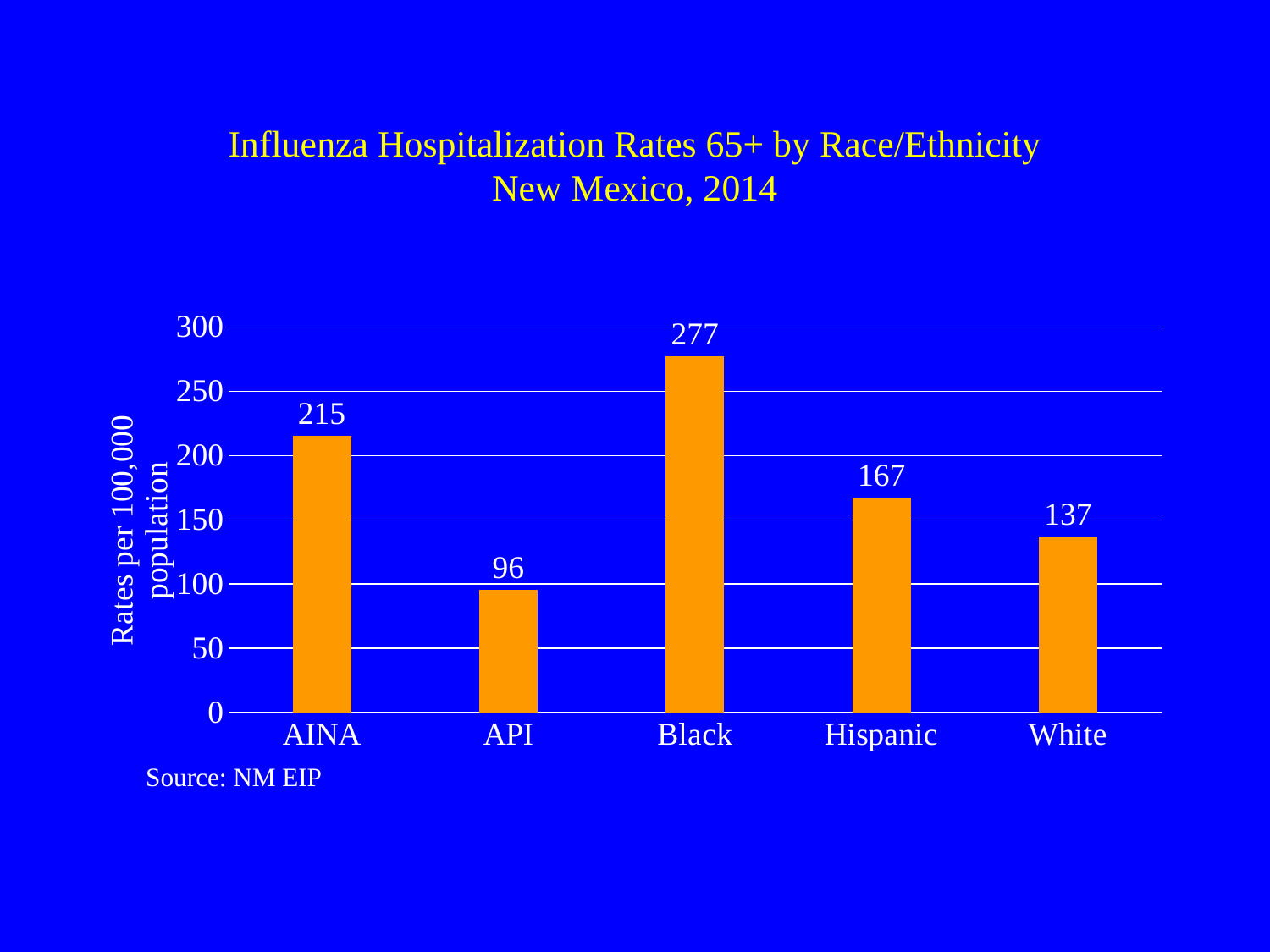
What is the influenza hospitalization rate for White? 137 Is the value for API greater or less than 100? less Which race/ethnicity category has the highest hospitalization rate? Black How many race/ethnicity categories are shown on the chart? 5 What type of chart is shown on the slide? Bar chart What is the difference between the rates for AINA and API? 119 What is the difference between the rates for Black and White? 140 What is the influenza hospitalization rate for AINA? 215 What is the influenza hospitalization rate for Hispanic? 167 Which race/ethnicity category has the lowest hospitalization rate? API Which has a higher hospitalization rate, Hispanic or White? Hispanic What is the influenza hospitalization rate for the Black category? 277